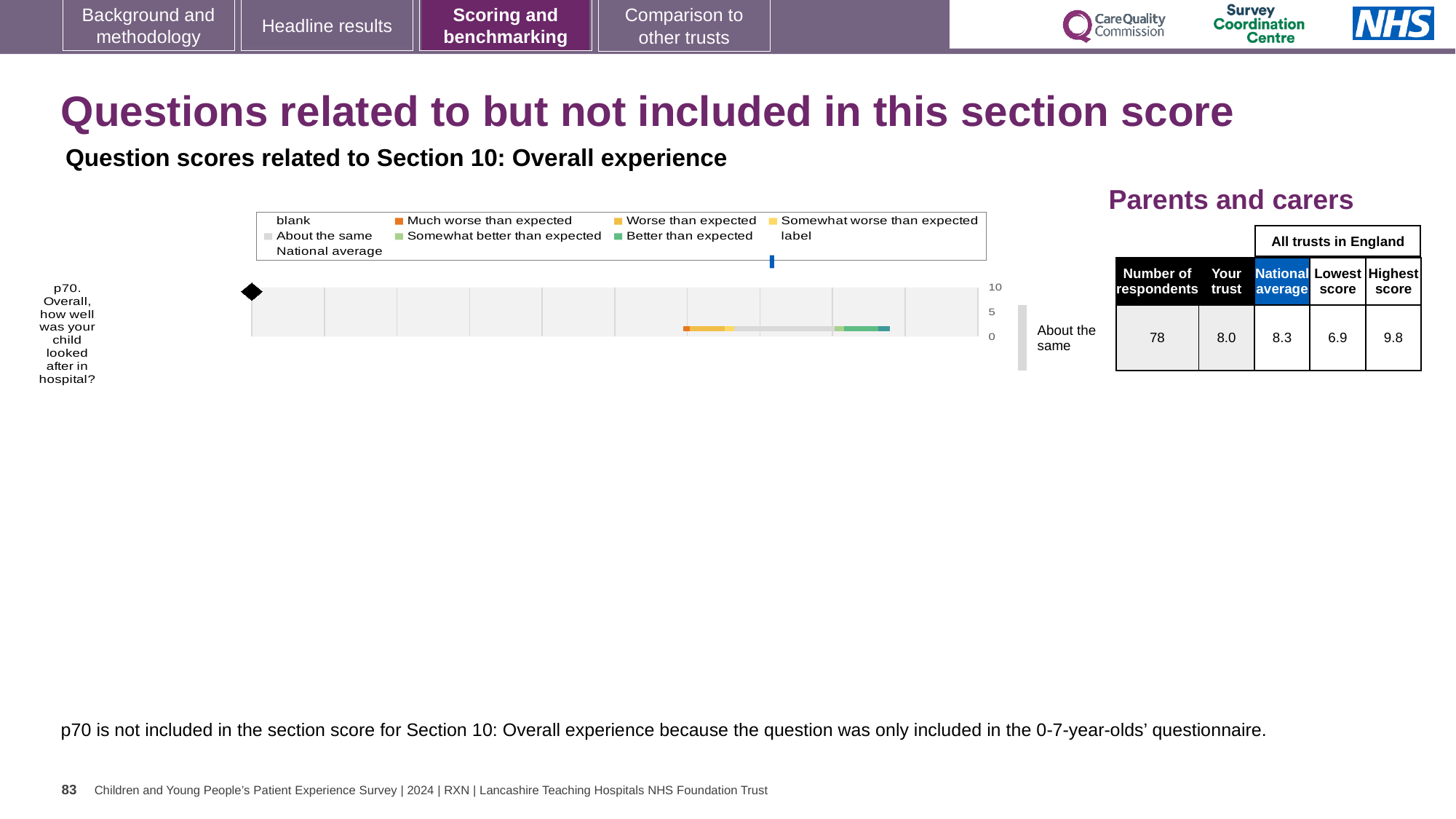
In the table next to the chart, what is the National average score for p70? 8.3 In the table next to the chart, what is the Lowest score among all trusts in England for p70? 6.9 Which question is plotted in the chart? p70. Overall, how well was your child looked after in hospital? In the table next to the chart, how many respondents answered p70? 78 According to the table, which is larger for p70: the trust's score or the national average? national average How many questions (categories) are plotted in the chart? 1 What kind of chart is shown for question p70? bar chart In the table next to the chart, what is the Highest score among all trusts in England for p70? 9.8 In the table next to the chart, what is the 'Your trust' score for p70? 8.0 According to the table, what is the difference between the Highest score and the Lowest score for p70? 2.9 What benchmark category label is shown to the right of the p70 bar? About the same What is the highest value shown on the chart's axis? 10